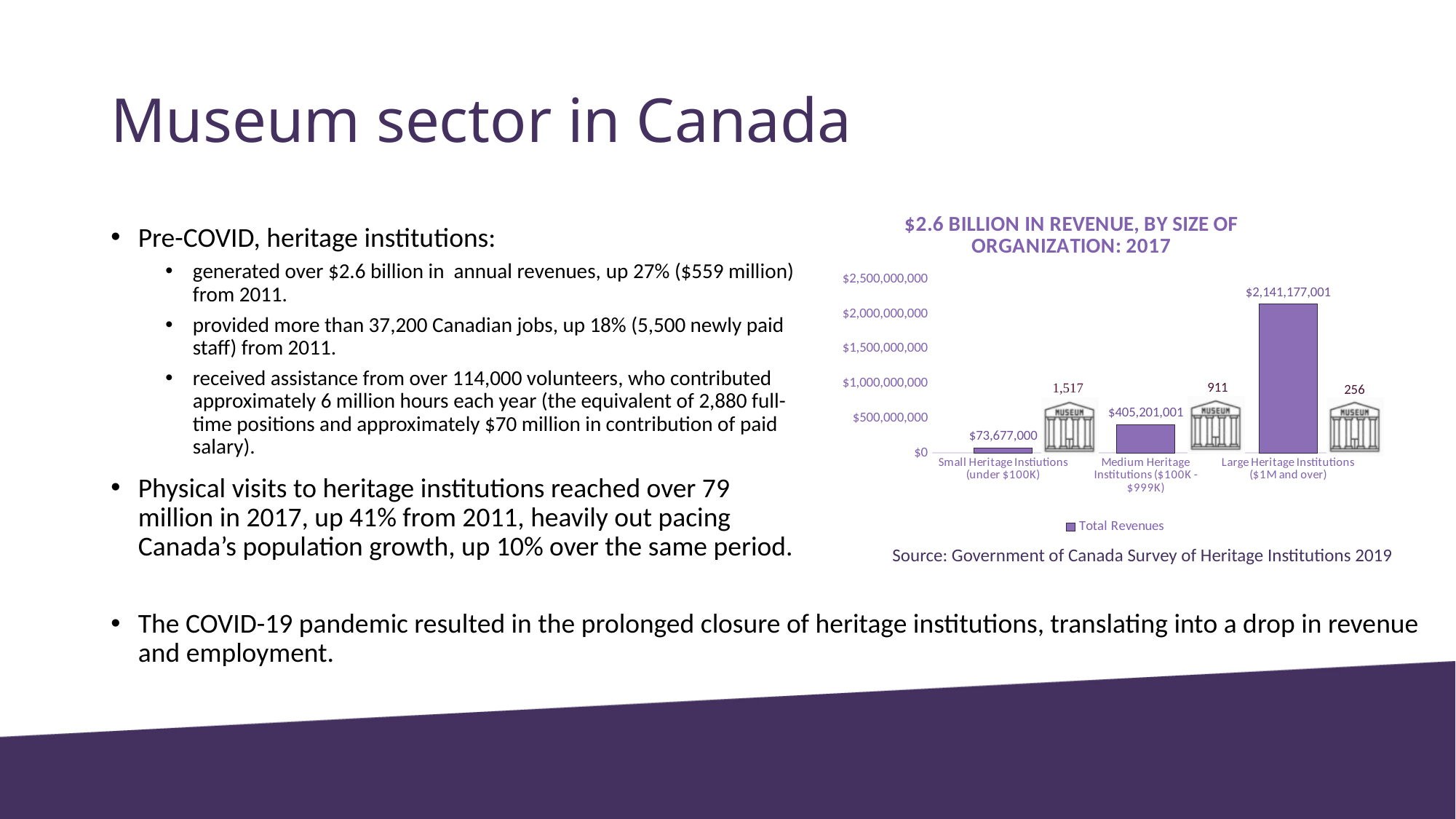
What is the Total Revenues value for Medium Heritage Institutions ($100K - $999K)? $405,201,001 What is the difference in Total Revenues between Medium Heritage Institutions and Small Heritage Institutions? $331,524,001 What is the Total Revenues value for Large Heritage Institutions ($1M and over)? $2,141,177,001 What is the title of the chart? $2.6 BILLION IN REVENUE, BY SIZE OF ORGANIZATION: 2017 What is the Total Revenues value for Small Heritage Institutions (under $100K)? $73,677,000 Which category has the highest Total Revenues? Large Heritage Institutions ($1M and over) What kind of chart is shown on the slide? Bar chart How many categories are shown on the x axis of the chart? 3 Is the Total Revenues value for Large Heritage Institutions greater or less than $2,000,000,000? greater Which has larger Total Revenues: Medium Heritage Institutions or Small Heritage Institutions? Medium Heritage Institutions Which category has the lowest Total Revenues? Small Heritage Institutions (under $100K) What is the difference in Total Revenues between Large Heritage Institutions and Medium Heritage Institutions? $1,735,976,000